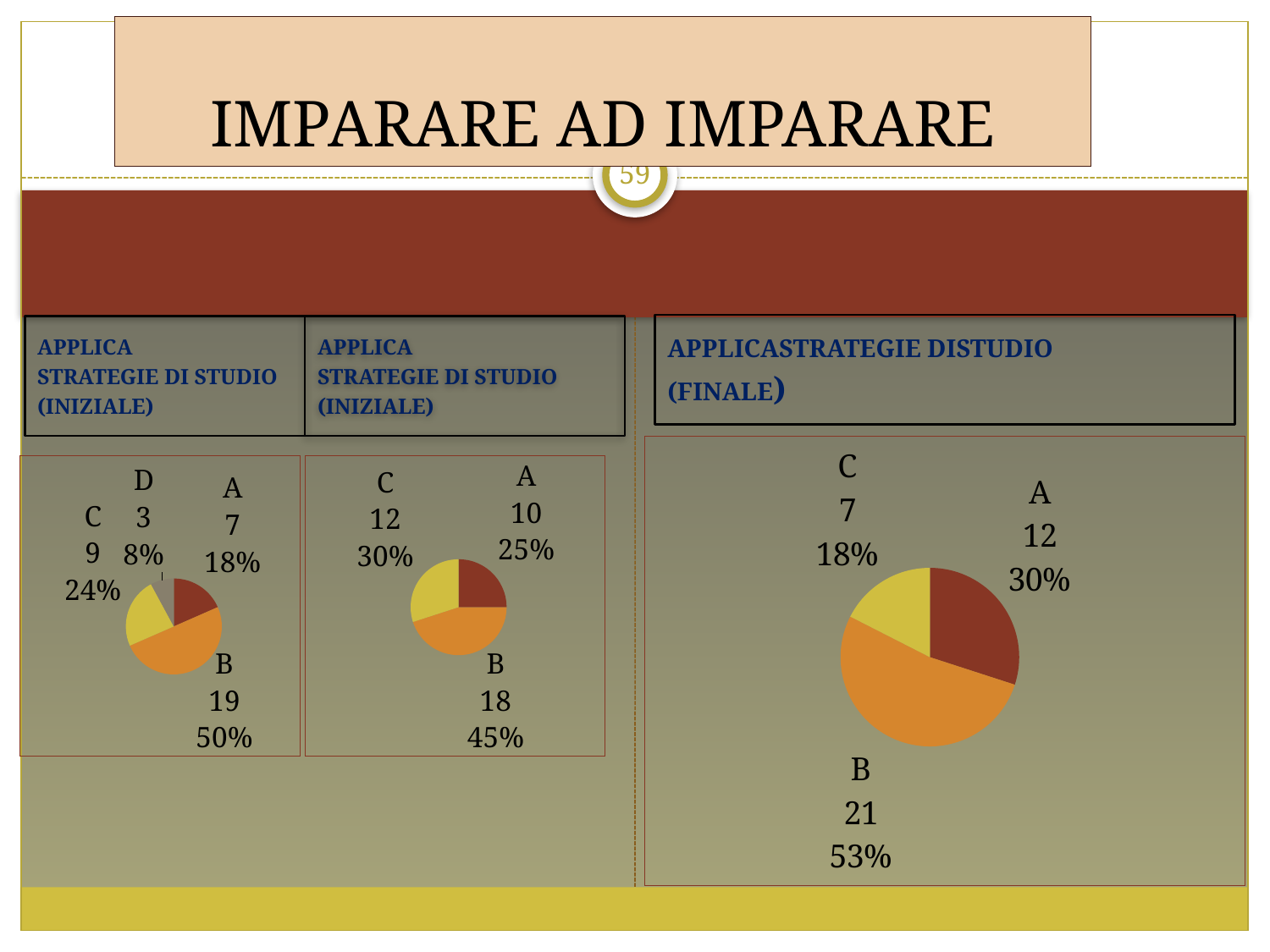
In the leftmost pie chart, which category has the smallest value? D In the middle pie chart, what is the difference between the values for B and A? 8 What kind of chart is the chart titled 'APPLICASTRATEGIE DISTUDIO (FINALE)'? Pie chart In the middle pie chart, which category has the largest value? B In the middle pie chart, what percentage share does category B have? 45% In the chart titled 'APPLICASTRATEGIE DISTUDIO (FINALE)', which is larger, the value for A or the value for C? A In the leftmost pie chart, what value is shown for category B? 19 In the chart titled 'APPLICASTRATEGIE DISTUDIO (FINALE)', what value is shown for category B? 21 In the leftmost pie chart, what percentage share does category D have? 8% In the middle pie chart, what value is shown for category C? 12 How many categories does the leftmost pie chart show? 4 In the chart titled 'APPLICASTRATEGIE DISTUDIO (FINALE)', what percentage share does category A have? 30%